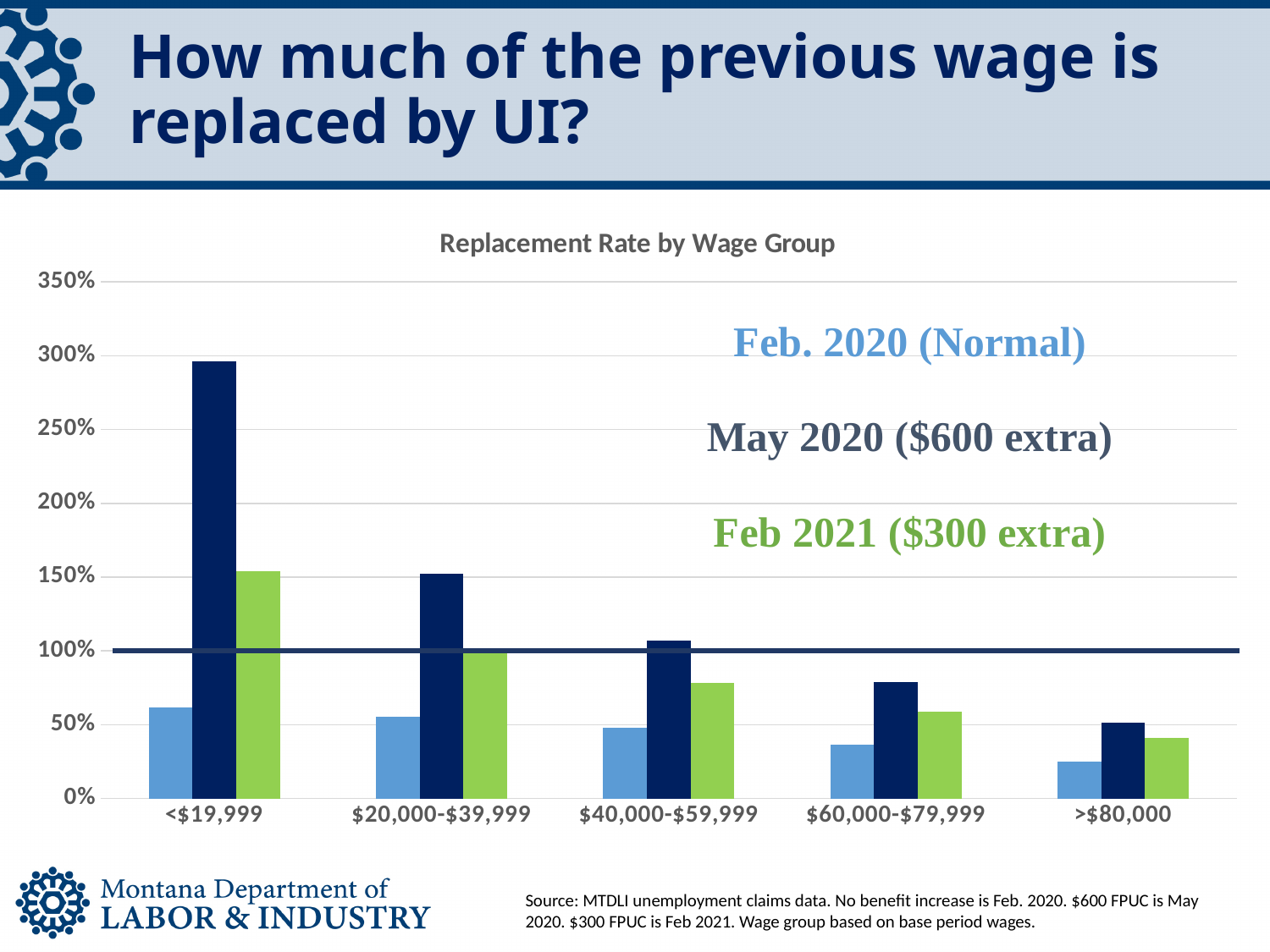
Which wage group has the lowest Feb. 2020 (Normal) replacement rate? >$80,000 Do the May 2020 ($600 extra) values rise or fall as wage group increases along the x axis? fall Which wage group has the highest May 2020 ($600 extra) replacement rate? <$19,999 Is the Feb. 2020 (Normal) value for the >$80,000 wage group greater or less than 50%? less How many series does the chart's legend list? 3 Is the May 2020 ($600 extra) value for the <$19,999 wage group greater or less than 250%? greater For the $40,000-$59,999 wage group, which series has the larger value: May 2020 ($600 extra) or Feb 2021 ($300 extra)? May 2020 ($600 extra) What kind of chart is shown on the slide? bar chart What is the title of the chart? Replacement Rate by Wage Group Is the Feb 2021 ($300 extra) value for the $20,000-$39,999 wage group greater or less than 150%? less How many wage groups are shown on the x axis? 5 Which series is shown in green? Feb 2021 ($300 extra)